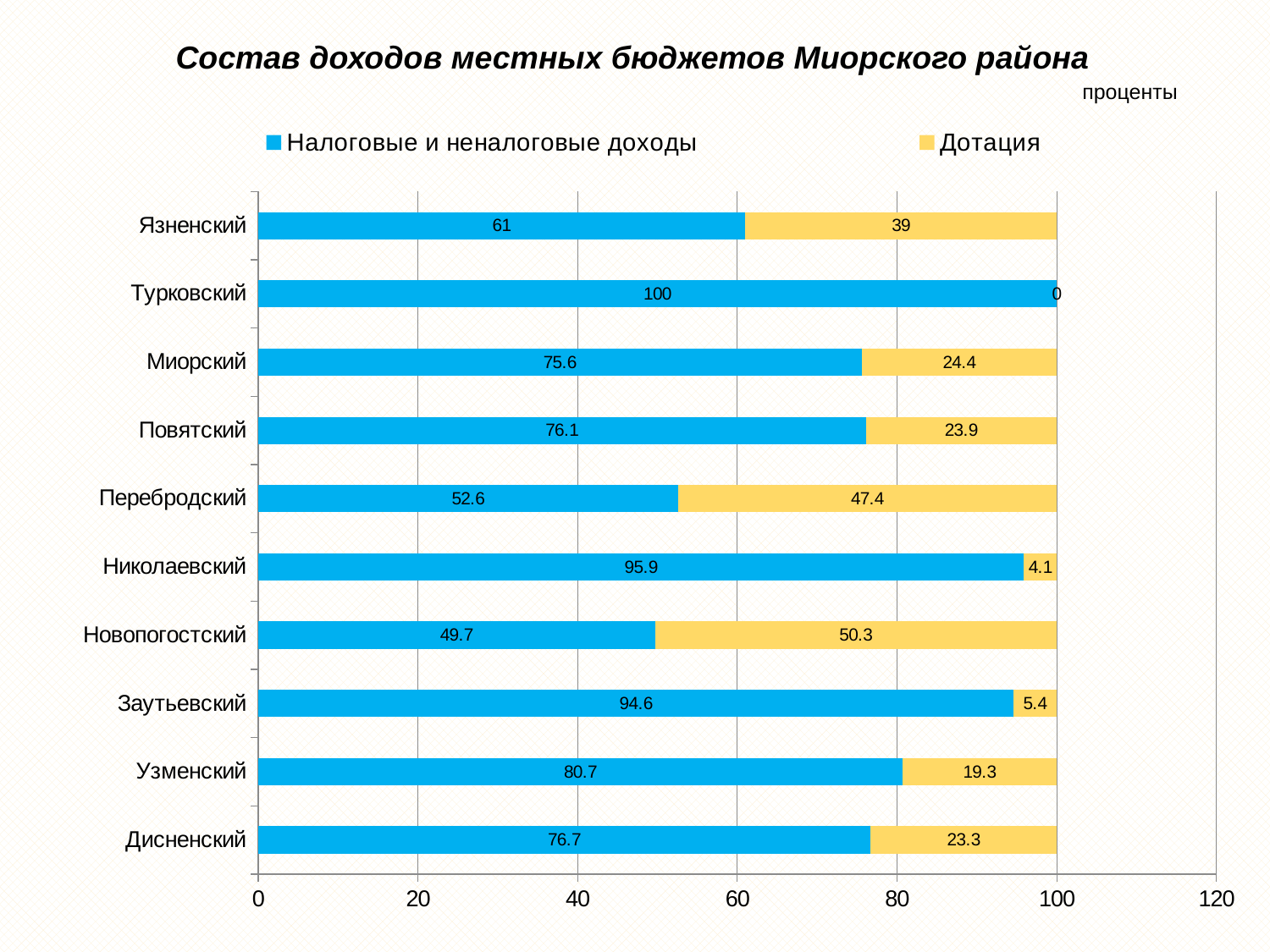
What is the value of Налоговые и неналоговые доходы for Миорский? 75.6 Which is larger: Налоговые и неналоговые доходы for Заутьевский or for Узменский? Заутьевский Which category has the lowest value for Налоговые и неналоговые доходы? Новопогостский How many series does the legend list? 2 Which category has the highest value for Дотация? Новопогостский How many categories are shown on the chart? 10 What is the value of Дотация for Николаевский? 4.1 Which category has the highest value for Налоговые и неналоговые доходы? Турковский What is the difference between the Дотация values for Язненский and Узменский? 19.7 What is the total of the stacked bar for Дисненский? 100 What is the value of Дотация for Перебродский? 47.4 What kind of chart is shown on the slide? Stacked bar chart